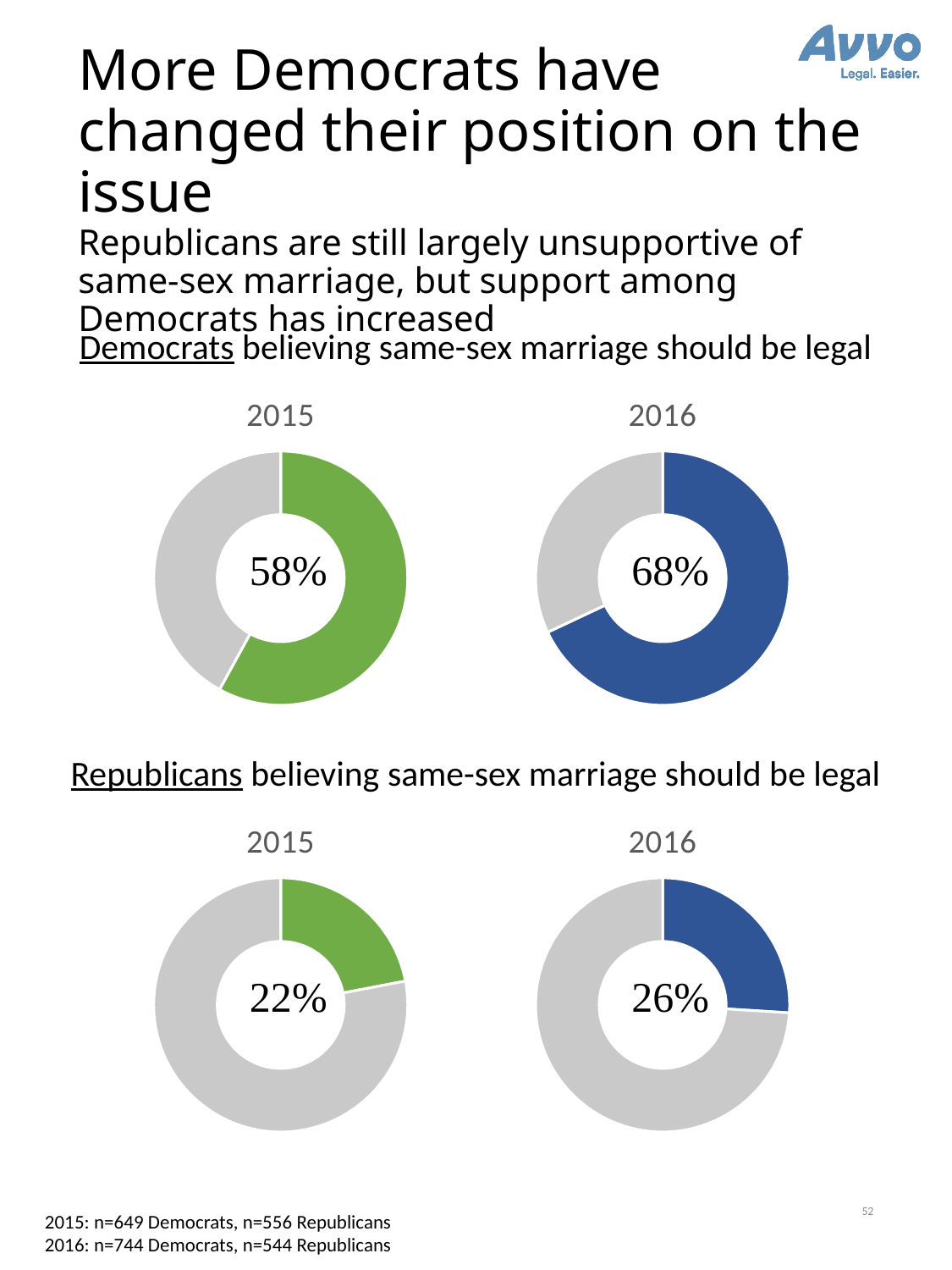
In the Democrats 2016 chart, what percentage of Democrats believed same-sex marriage should be legal? 68% In the Republicans 2015 chart, what percentage of Republicans believed same-sex marriage should be legal? 22% How many doughnut charts are shown on the slide? 4 In the Democrats 2016 chart, what share of the ring is grey (not supporting)? 32% Across the Democrats charts, by how many percentage points did support rise from 2015 to 2016? 10 Comparing the 2015 charts, which group had the lower share believing same-sex marriage should be legal, Democrats or Republicans? Republicans Comparing the 2016 charts, which group had the higher share believing same-sex marriage should be legal, Democrats or Republicans? Democrats Across the Republicans charts, by how many percentage points did support rise from 2015 to 2016? 4 In the Republicans 2016 chart, what percentage of Republicans believed same-sex marriage should be legal? 26% What colour is the highlighted segment in the 2015 charts? Green In the Democrats 2015 chart, what percentage of Democrats believed same-sex marriage should be legal? 58% What kind of chart is used to show the Democrats 2015 value? Doughnut chart